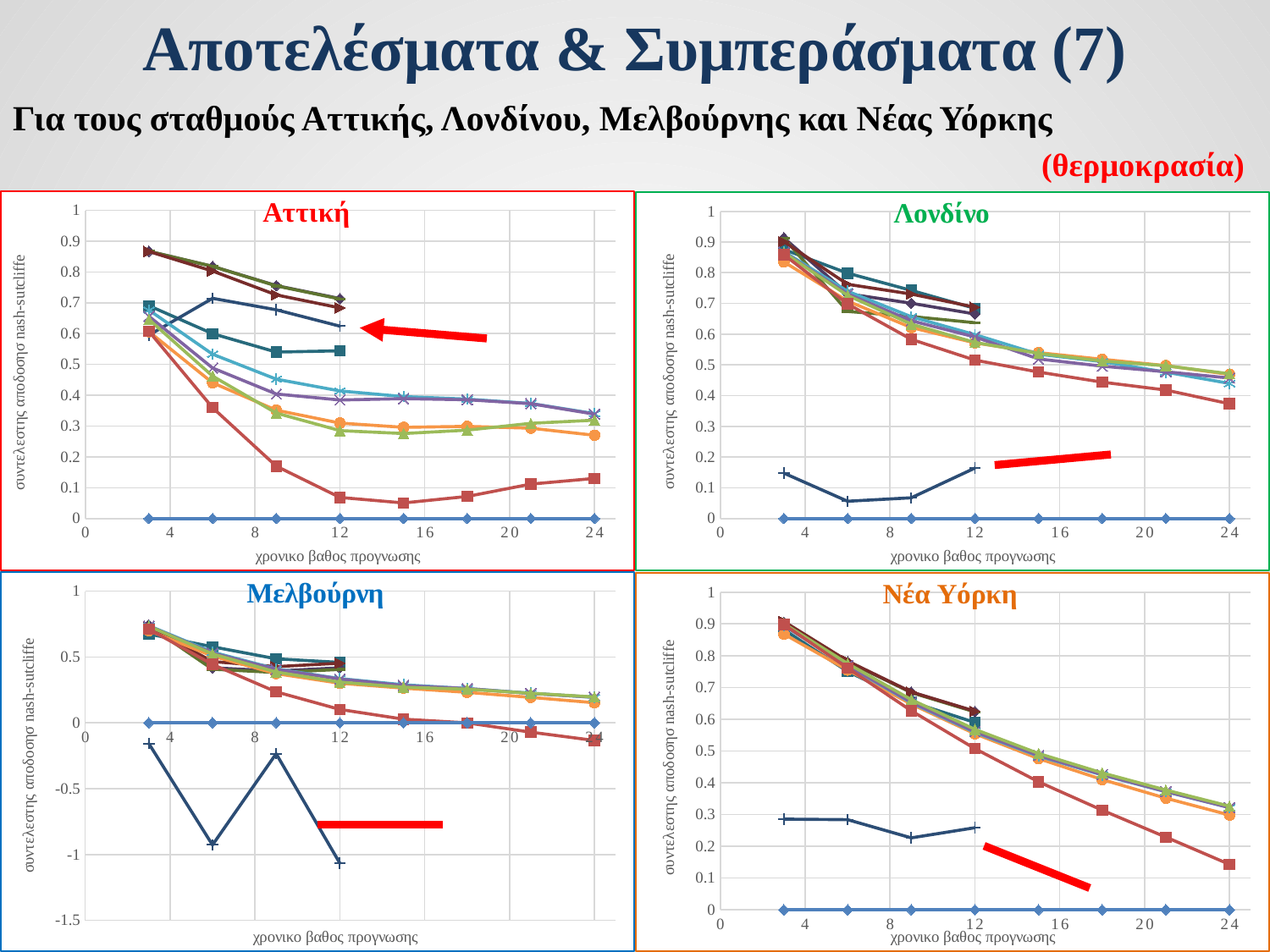
What is the x-axis label of the Λονδίνο chart? χρονικο βαθος προγνωσης In the Αττική chart, at x=24, is the red square-marker series higher or lower than the orange circle-marker series? lower In the Νέα Υόρκη chart, how many data points does the red square-marker series have? 8 In the Αττική chart, is the value of the red square-marker series at x=12 greater or less than 0.1? less What is the y-axis label of the Νέα Υόρκη chart? συντελεστης αποδοσης nash-sutcliffe In the Μελβούρνη chart, is the value of the plus-marker series at x=9 greater or less than -0.5? greater In the Λονδίνο chart, is the value of the plus-marker series at x=6 greater or less than 0.1? less How many charts are shown on the slide? 4 In the Λονδίνο chart, does the red square-marker series rise or fall from x=3 to x=24? fall In the Νέα Υόρκη chart, do the values of the upper group of lines rise or fall as the x-axis value increases? fall What kind of chart is the Αττική chart? line chart